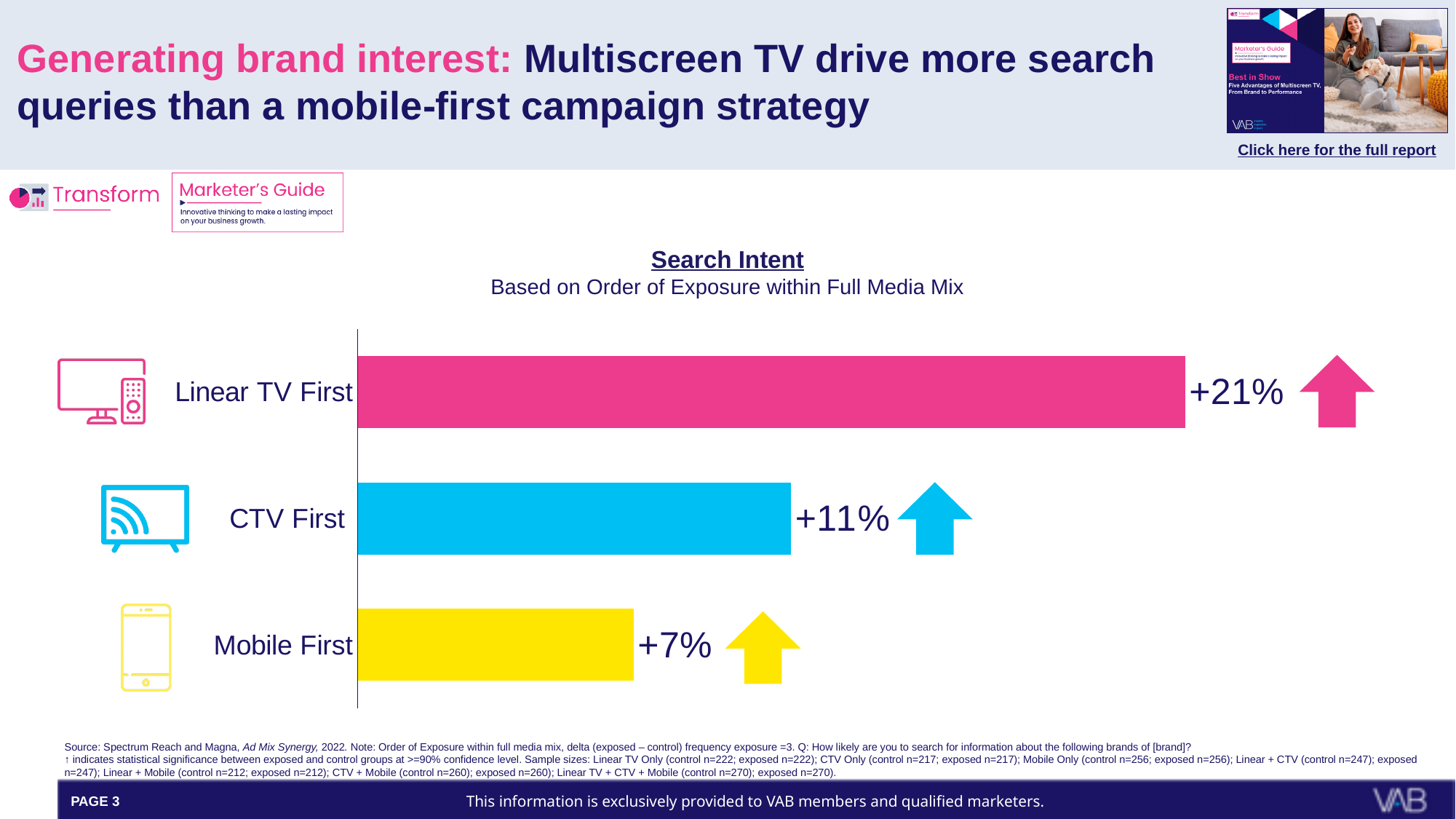
Which category has the highest value? Linear TV First What is the difference between the values for Linear TV First and Mobile First? 14% What is the value for CTV First? +11% What colour is the bar for CTV First? Blue What is the title of the chart? Search Intent Which category has the lowest value? Mobile First What is the value for Linear TV First? +21% What is the difference between the values for Linear TV First and CTV First? 10% How many categories are shown in the chart? 3 What is the value for Mobile First? +7% What kind of chart is shown on the slide? Bar chart Which is larger, the value for CTV First or the value for Mobile First? CTV First